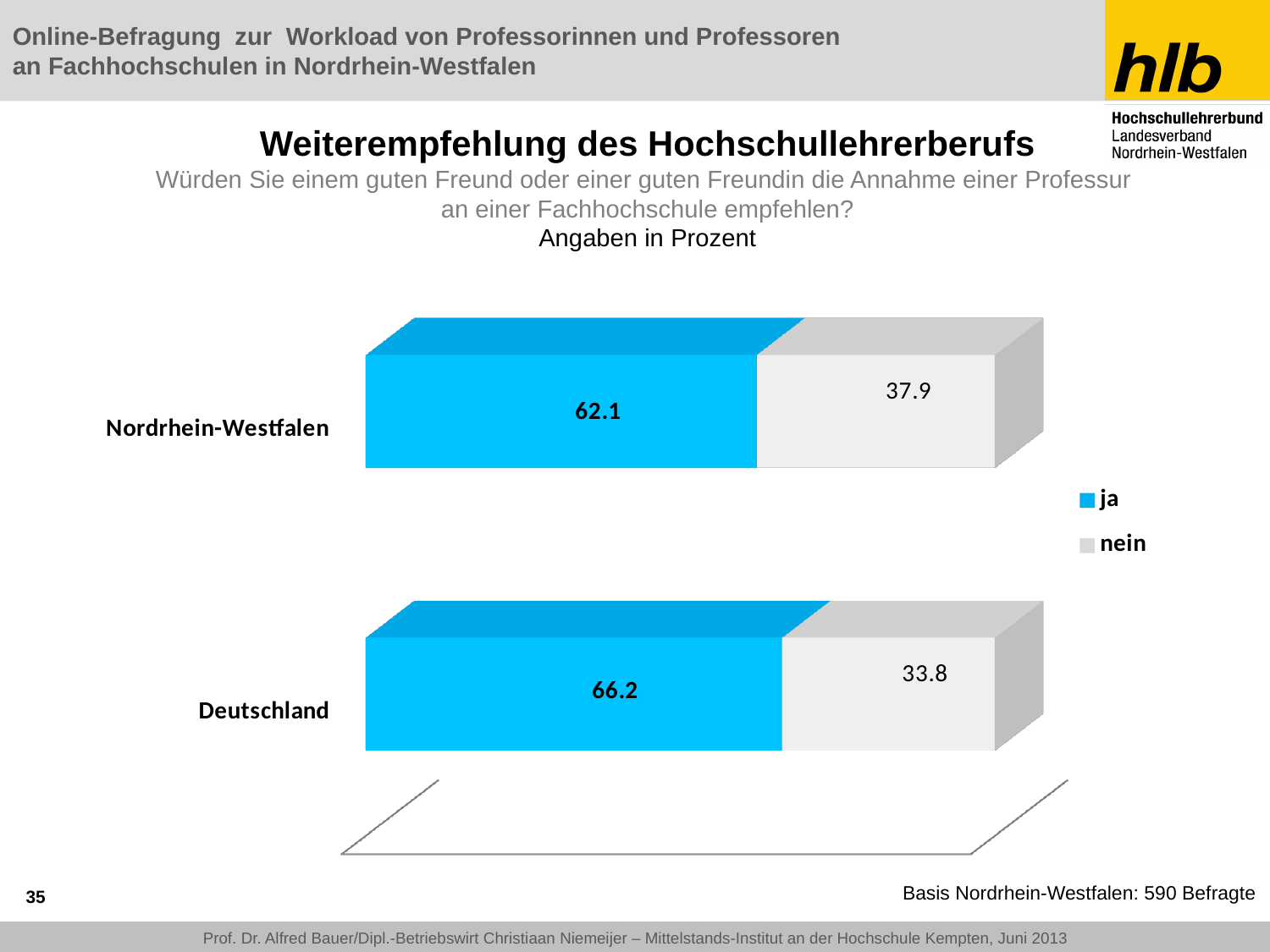
How many series does the legend list? 2 What is the difference between the "ja" and "nein" values for Nordrhein-Westfalen? 24.2 What is the value for "nein" for Nordrhein-Westfalen? 37.9 What is the value for "ja" for Nordrhein-Westfalen? 62.1 Which category has the higher "ja" value, Nordrhein-Westfalen or Deutschland? Deutschland What is the total of the stacked bar for Deutschland? 100 What kind of chart is shown on the slide? Stacked bar chart How many categories are shown in the chart? 2 Which category has the higher "nein" value, Nordrhein-Westfalen or Deutschland? Nordrhein-Westfalen What is the value for "ja" for Deutschland? 66.2 What is the value for "nein" for Deutschland? 33.8 What is the difference between the "ja" values for Deutschland and Nordrhein-Westfalen? 4.1